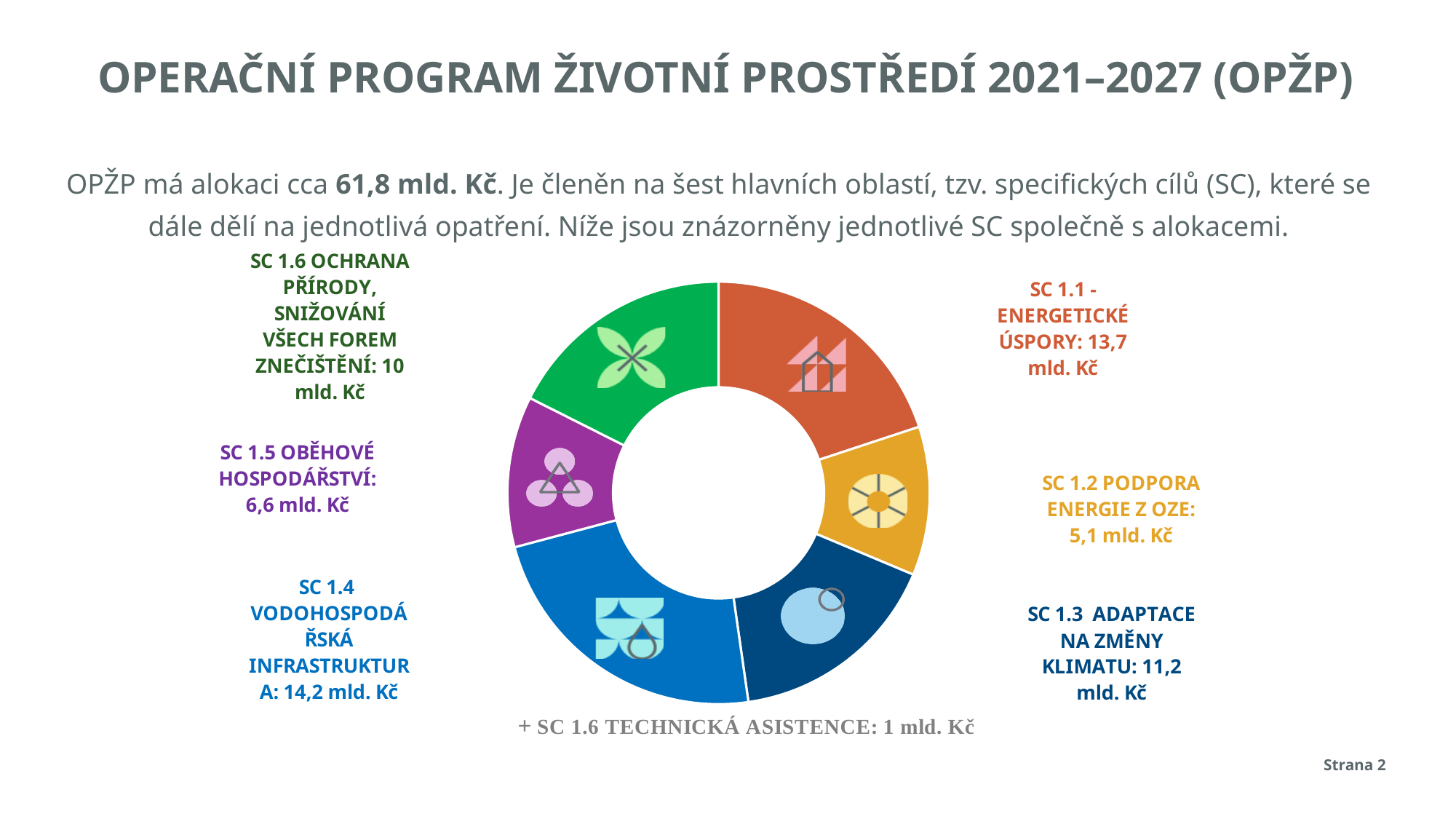
What colour is the segment for SC 1.5 Oběhové hospodářství? Purple What kind of chart is shown on the slide? Donut (pie) chart What is the difference between the allocations for SC 1.4 and SC 1.1? 0,5 mld. Kč What is the total of the six allocations shown in the chart? 60,8 mld. Kč What is the allocation shown for SC 1.5 Oběhové hospodářství? 6,6 mld. Kč What is the allocation shown for SC 1.1 Energetické úspory? 13,7 mld. Kč How many segments does the donut chart have? 6 What is the allocation shown for SC 1.3 Adaptace na změny klimatu? 11,2 mld. Kč Which specific objective (SC) has the largest allocation in the chart? SC 1.4 Vodohospodářská infrastruktura Which has the larger allocation, SC 1.3 or SC 1.6 Ochrana přírody? SC 1.3 What is the allocation shown for SC 1.2 Podpora energie z OZE? 5,1 mld. Kč Which specific objective (SC) has the smallest allocation in the chart? SC 1.2 Podpora energie z OZE